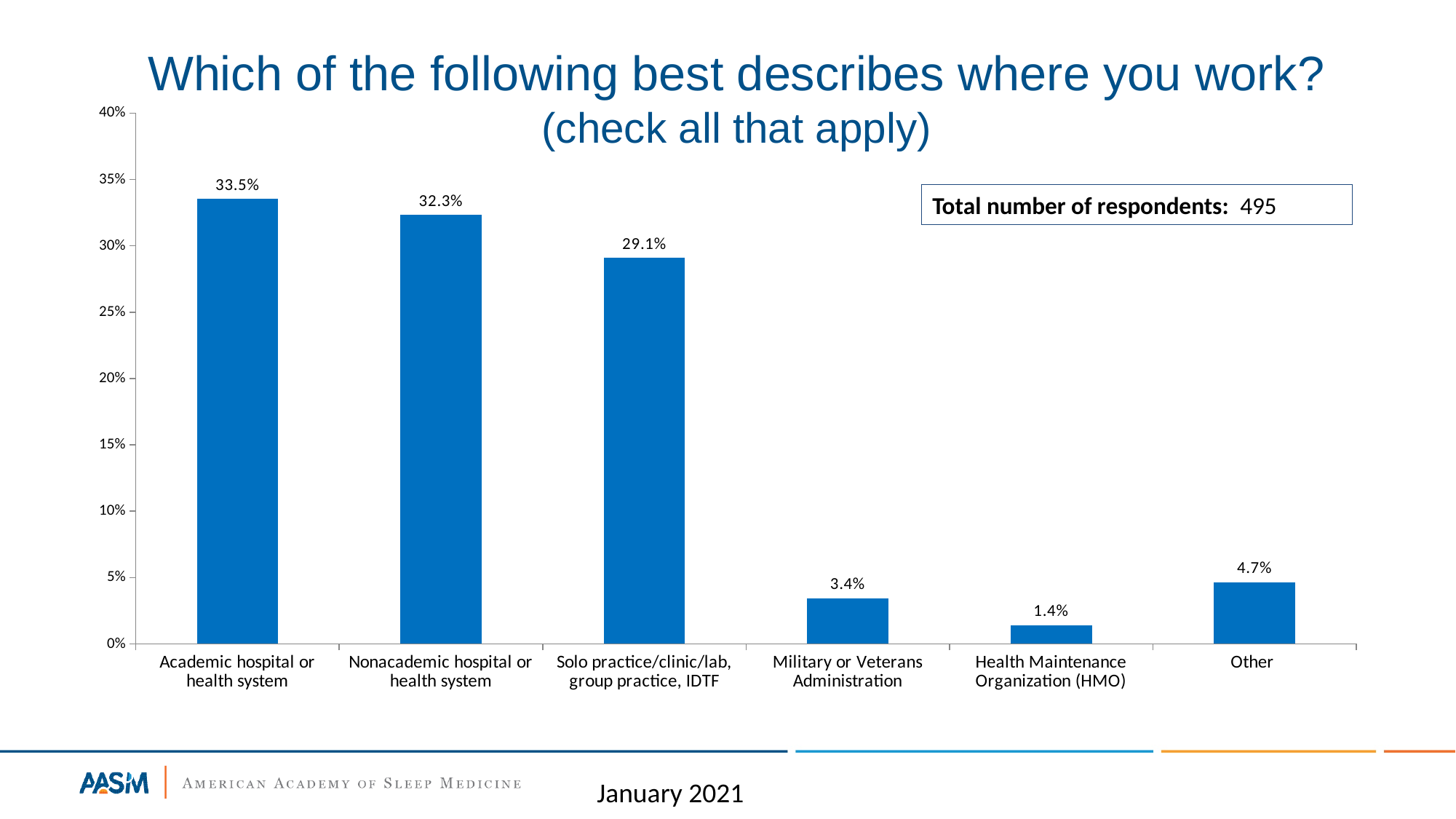
How many categories are shown on the x axis? 6 Is the value for Solo practice/clinic/lab, group practice, IDTF greater or less than 30%? less Which category has the highest value? Academic hospital or health system What is the total number of respondents stated on the slide? 495 What is the value for Health Maintenance Organization (HMO)? 1.4% Which category has the lowest value? Health Maintenance Organization (HMO) What kind of chart is shown on the slide? bar chart Which is larger, the value for Other or the value for Military or Veterans Administration? Other What percentage of respondents work at an academic hospital or health system? 33.5% What is the difference between the values for Academic hospital or health system and Nonacademic hospital or health system? 1.2% What is the difference between the values for Other and Military or Veterans Administration? 1.3% What is the value for Solo practice/clinic/lab, group practice, IDTF? 29.1%